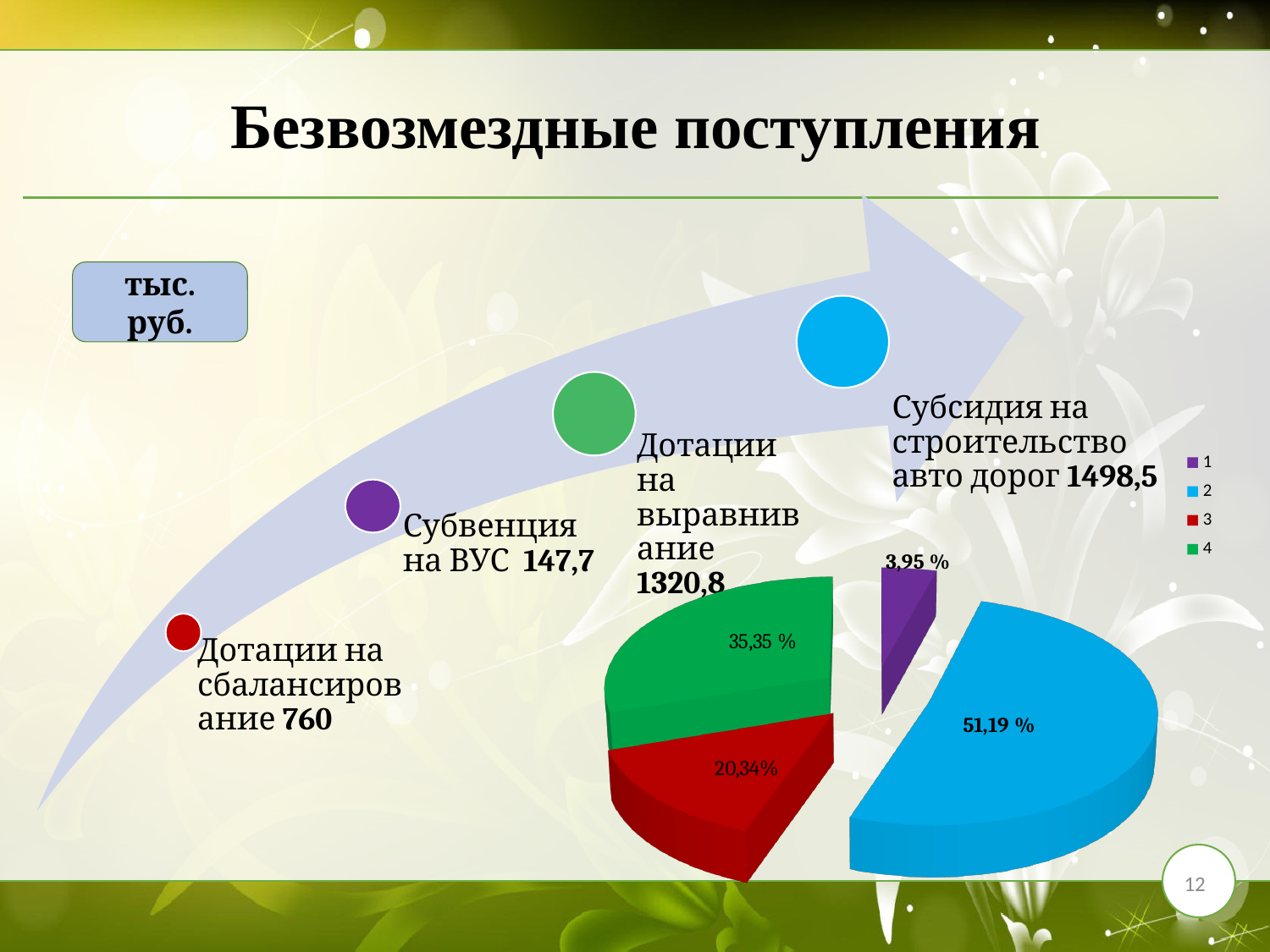
How many entries does the pie chart's legend list? 4 What share of the pie does the green slice (legend entry 4) represent? 35,35 % What share of the pie does the purple slice (legend entry 1) represent? 3,95 % What share of the pie does the blue slice (legend entry 2) represent? 51,19 % What colour is the slice labelled 51,19 % in the pie chart? blue Which legend entry corresponds to the smallest slice of the pie chart? 1 How many slices does the pie chart have? 4 What kind of chart is shown on the slide? pie chart Which slice is larger in the pie chart: the red slice (3) or the green slice (4)? green slice (4) Which legend entry corresponds to the largest slice of the pie chart? 2 What is the difference in percentage points between the blue slice (51,19 %) and the green slice (35,35 %)? 15,84